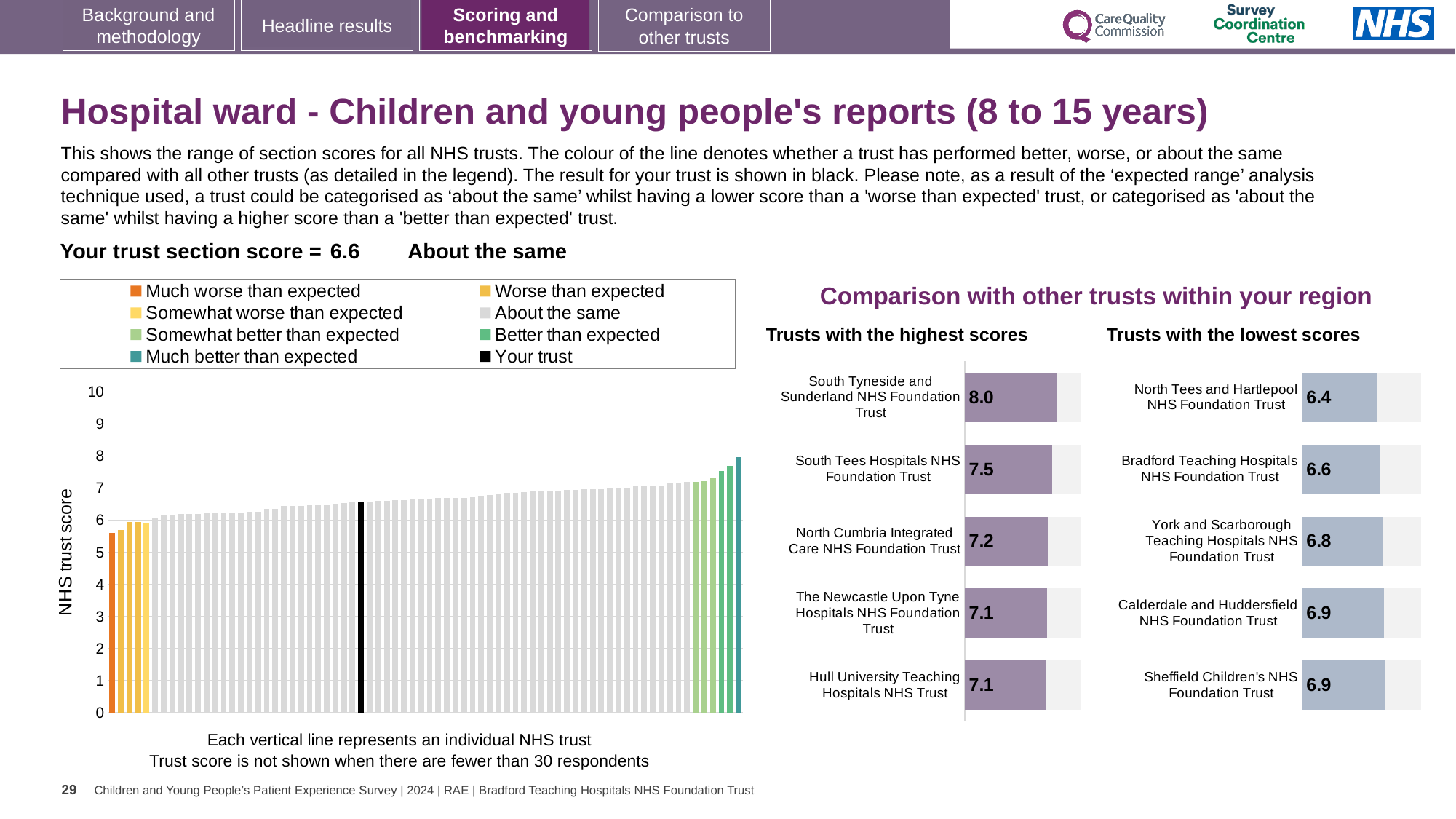
What kind of chart is the large chart on the left with the y axis labelled 'NHS trust score'? bar chart In the 'Trusts with the lowest scores' chart, which has the larger score: Bradford Teaching Hospitals NHS Foundation Trust or York and Scarborough Teaching Hospitals NHS Foundation Trust? York and Scarborough Teaching Hospitals NHS Foundation Trust In the 'Trusts with the lowest scores' chart, what is the difference between the scores of York and Scarborough Teaching Hospitals NHS Foundation Trust and North Tees and Hartlepool NHS Foundation Trust? 0.4 In the 'Trusts with the lowest scores' chart, which trust has the lowest score? North Tees and Hartlepool NHS Foundation Trust In the 'Trusts with the highest scores' chart, how many trusts are shown? 5 In the large chart on the left, is the value of the tallest bar greater or less than 7? greater In the 'Trusts with the highest scores' chart, which trust has the highest score? South Tyneside and Sunderland NHS Foundation Trust In the large chart on the left, do the trust scores rise or fall from left to right? rise In the 'Trusts with the highest scores' chart, what is the score for South Tyneside and Sunderland NHS Foundation Trust? 8.0 How many entries does the legend of the large chart on the left list? 8 In the 'Trusts with the lowest scores' chart, what is the score for North Tees and Hartlepool NHS Foundation Trust? 6.4 In the 'Trusts with the highest scores' chart, what is the difference between the scores of South Tyneside and Sunderland NHS Foundation Trust and South Tees Hospitals NHS Foundation Trust? 0.5